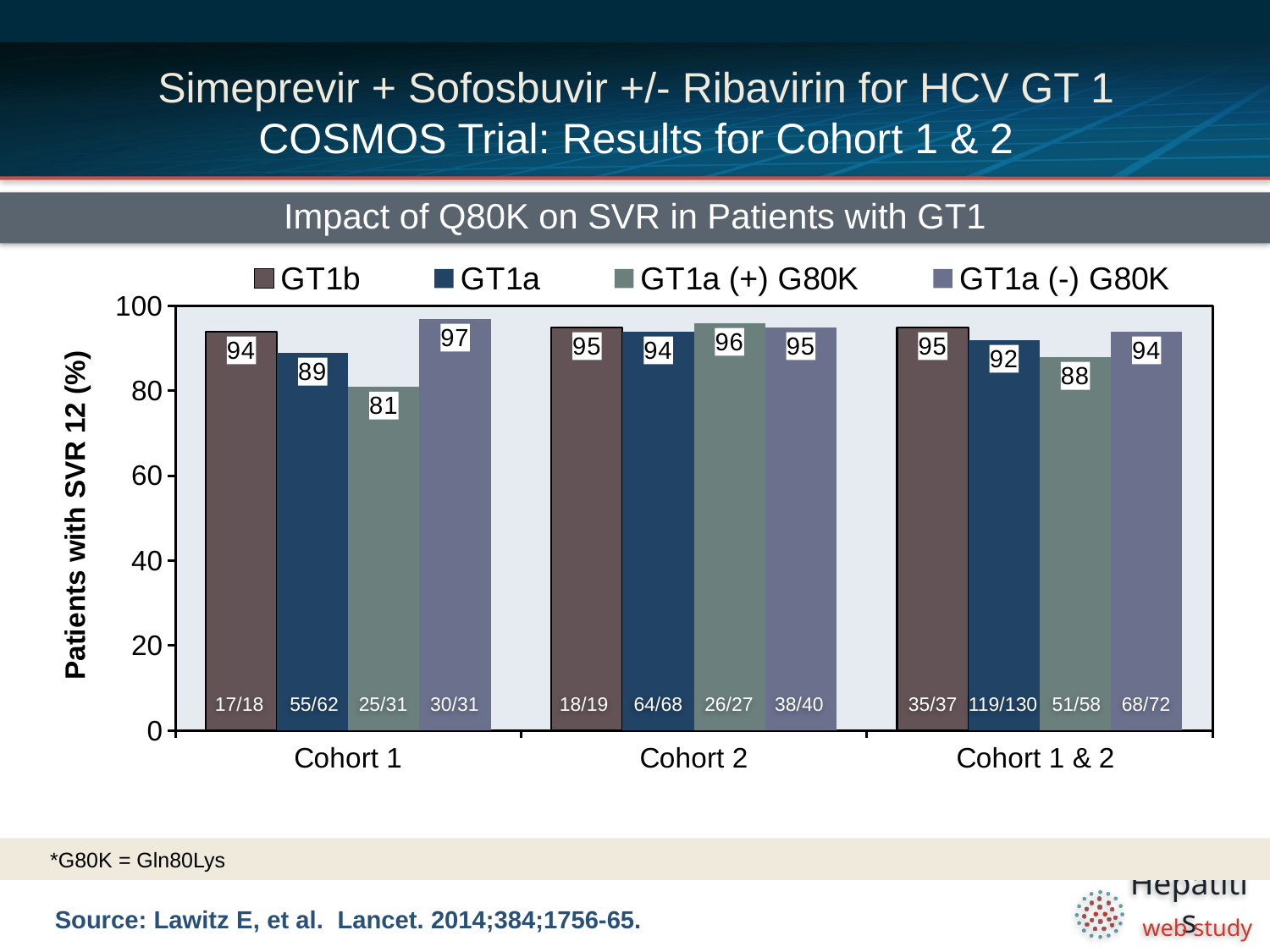
What is the difference between the GT1a (-) G80K and GT1a (+) G80K SVR 12 rates in Cohort 1? 16 What is the SVR 12 rate for GT1a (-) G80K in Cohort 1? 97 What is the SVR 12 rate for GT1a in Cohort 1 & 2? 92 In Cohort 1 & 2, which is larger: the SVR 12 rate for GT1a (+) G80K or GT1a (-) G80K? GT1a (-) G80K How many series does the legend list? 4 What is the SVR 12 rate for GT1a (+) G80K in Cohort 2? 96 Which series has the lowest SVR 12 rate in Cohort 1? GT1a (+) G80K What is the SVR 12 rate for GT1a (+) G80K in Cohort 1? 81 What kind of chart is shown on the slide? Bar chart What is the title of the chart? Impact of Q80K on SVR in Patients with GT1 How many cohort groups are shown on the x axis? 3 Which series has the highest SVR 12 rate in Cohort 1? GT1a (-) G80K